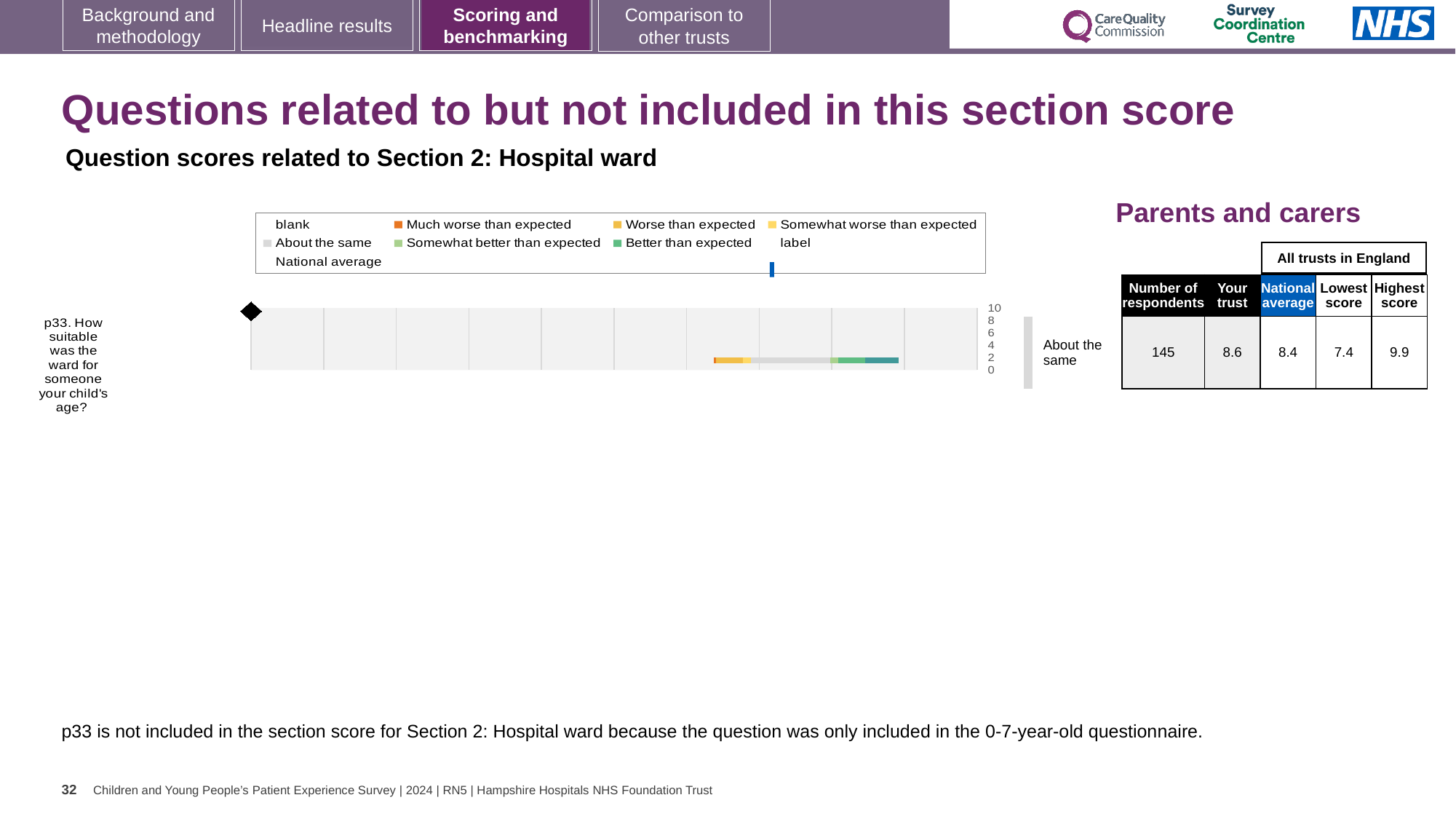
Which question is plotted in the chart? p33. How suitable was the ward for someone your child's age? In the table beside the chart, what is the highest score among all trusts in England for p33? 9.9 Which legend entry is shown in orange? Much worse than expected What kind of chart is used to show the p33 question score? bar chart What benchmark category label is shown next to the bar for p33? About the same Is the 'Your trust' score for p33 higher or lower than the national average? higher How many entries does the chart legend list? 9 In the table beside the chart, what is the lowest score among all trusts in England for p33? 7.4 In the table beside the chart, what is the national average score for p33? 8.4 In the table beside the chart, what is the 'Your trust' score for p33? 8.6 In the table beside the chart, how many respondents answered p33? 145 How many questions are plotted in the chart? 1